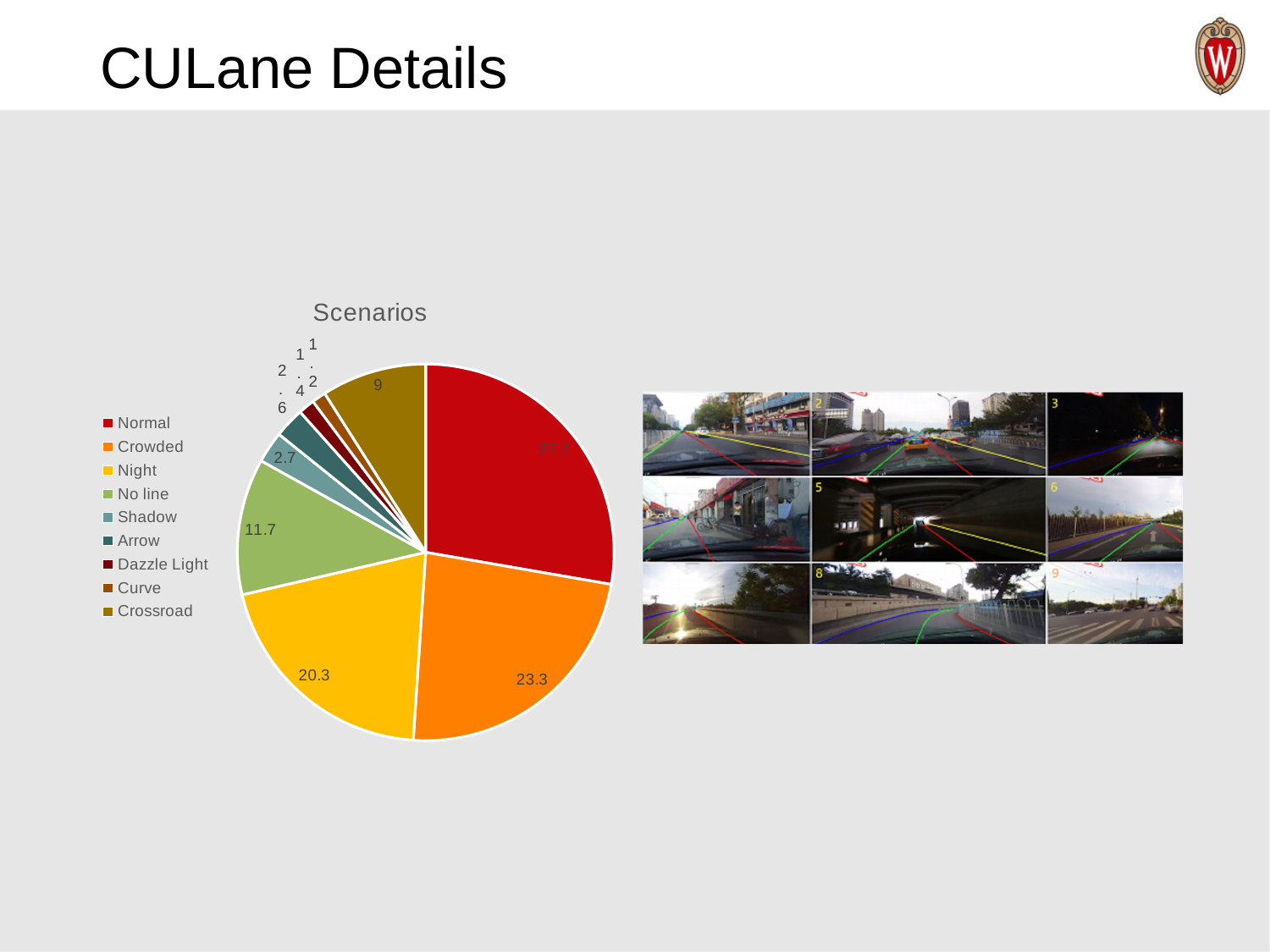
What is the value for Crowded in the Scenarios pie chart? 23.3 Which category has the largest slice in the Scenarios pie chart? Normal What kind of chart is shown on the slide? pie chart What is the value for Crossroad in the Scenarios pie chart? 9 What is the value for Normal in the Scenarios pie chart? 27.7 What is the title of the pie chart? Scenarios What is the value for No line in the Scenarios pie chart? 11.7 What is the value for Shadow in the Scenarios pie chart? 2.7 How many categories does the Scenarios pie chart have? 9 What is the value for Night in the Scenarios pie chart? 20.3 What is the difference between the Normal and Crowded values in the Scenarios pie chart? 4.4 Which is larger in the Scenarios pie chart, Night or No line? Night